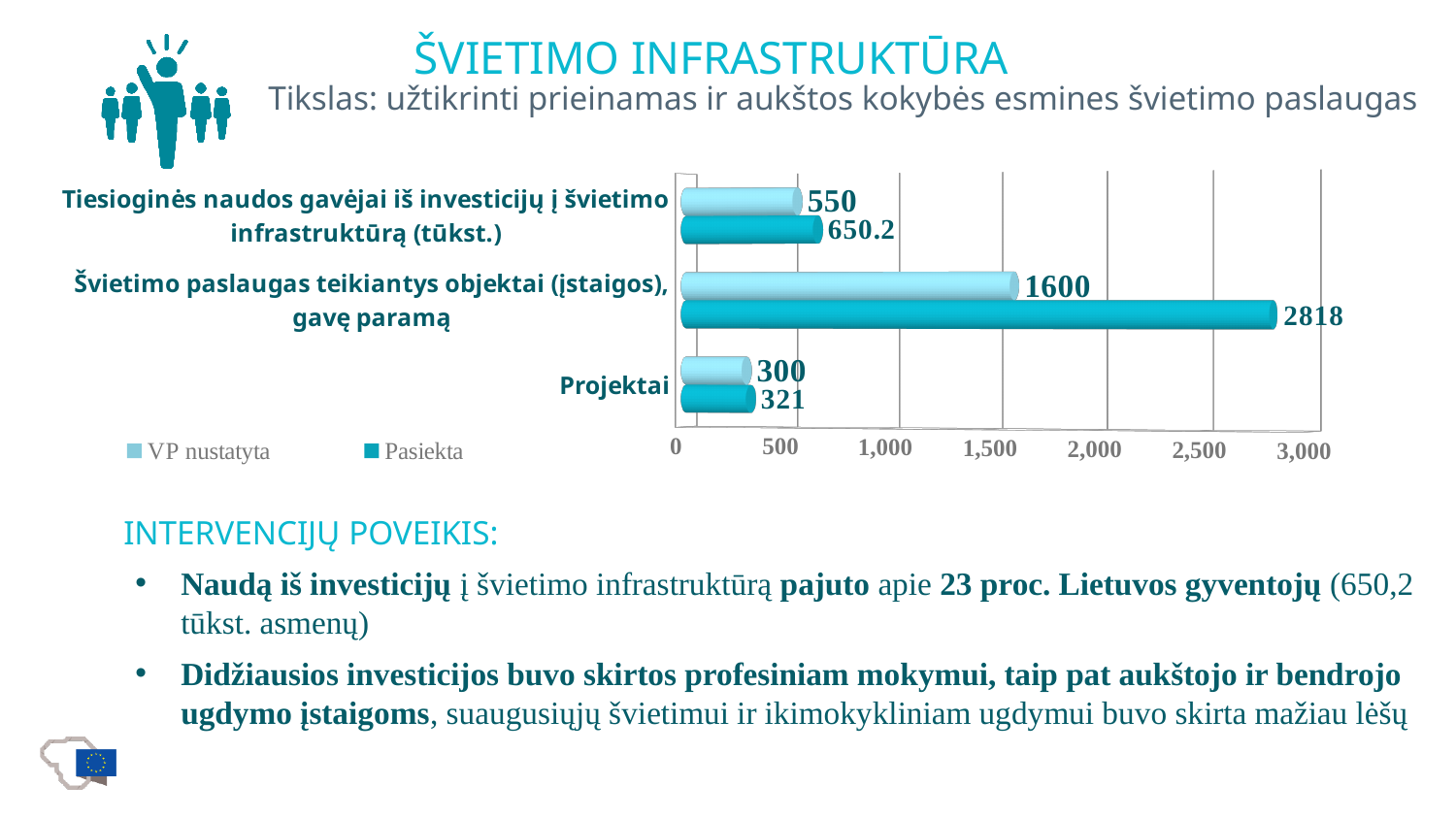
Which is larger for "Tiesioginės naudos gavėjai iš investicijų į švietimo infrastruktūrą (tūkst.)": the "VP nustatyta" value or the "Pasiekta" value? Pasiekta How many series does the chart legend list? 2 What is the "Pasiekta" value for "Projektai"? 321 What is the "VP nustatyta" value for "Tiesioginės naudos gavėjai iš investicijų į švietimo infrastruktūrą (tūkst.)"? 550 What is the "VP nustatyta" value for "Projektai"? 300 Which category has the highest "Pasiekta" value? Švietimo paslaugas teikiantys objektai (įstaigos), gavę paramą What is the "Pasiekta" value for "Švietimo paslaugas teikiantys objektai (įstaigos), gavę paramą"? 2818 What is the difference between the "Pasiekta" and "VP nustatyta" values for "Švietimo paslaugas teikiantys objektai (įstaigos), gavę paramą"? 1218 How many categories are shown on the chart? 3 What are the two series names listed in the chart legend? VP nustatyta and Pasiekta Which category has the lowest "VP nustatyta" value? Projektai What kind of chart is shown on the slide? bar chart